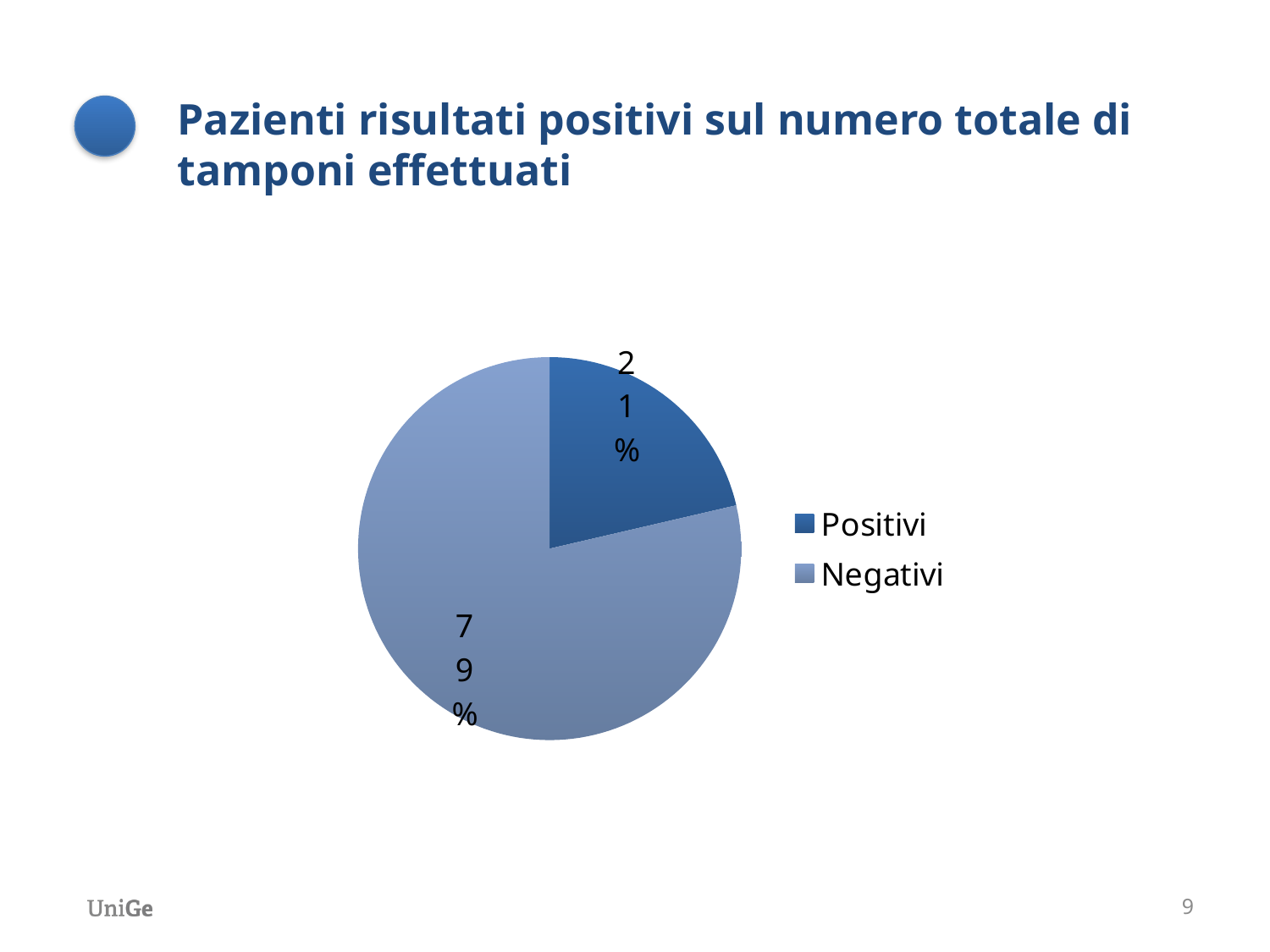
Which slice is the smallest in the pie chart? Positivi Is the share for Negativi greater or less than 50%? greater How many slices does the pie chart have? 2 Which legend entry is shown in the darker blue colour? Positivi What share of the pie does the Positivi slice represent? 21% What is the difference in percentage points between the Negativi and Positivi slices? 58 What is the title of the slide containing the pie chart? Pazienti risultati positivi sul numero totale di tamponi effettuati What kind of chart is shown on the slide? pie chart How many entries does the legend list? 2 Which slice is the largest in the pie chart? Negativi Which is larger, the Positivi slice or the Negativi slice? Negativi What share of the pie does the Negativi slice represent? 79%